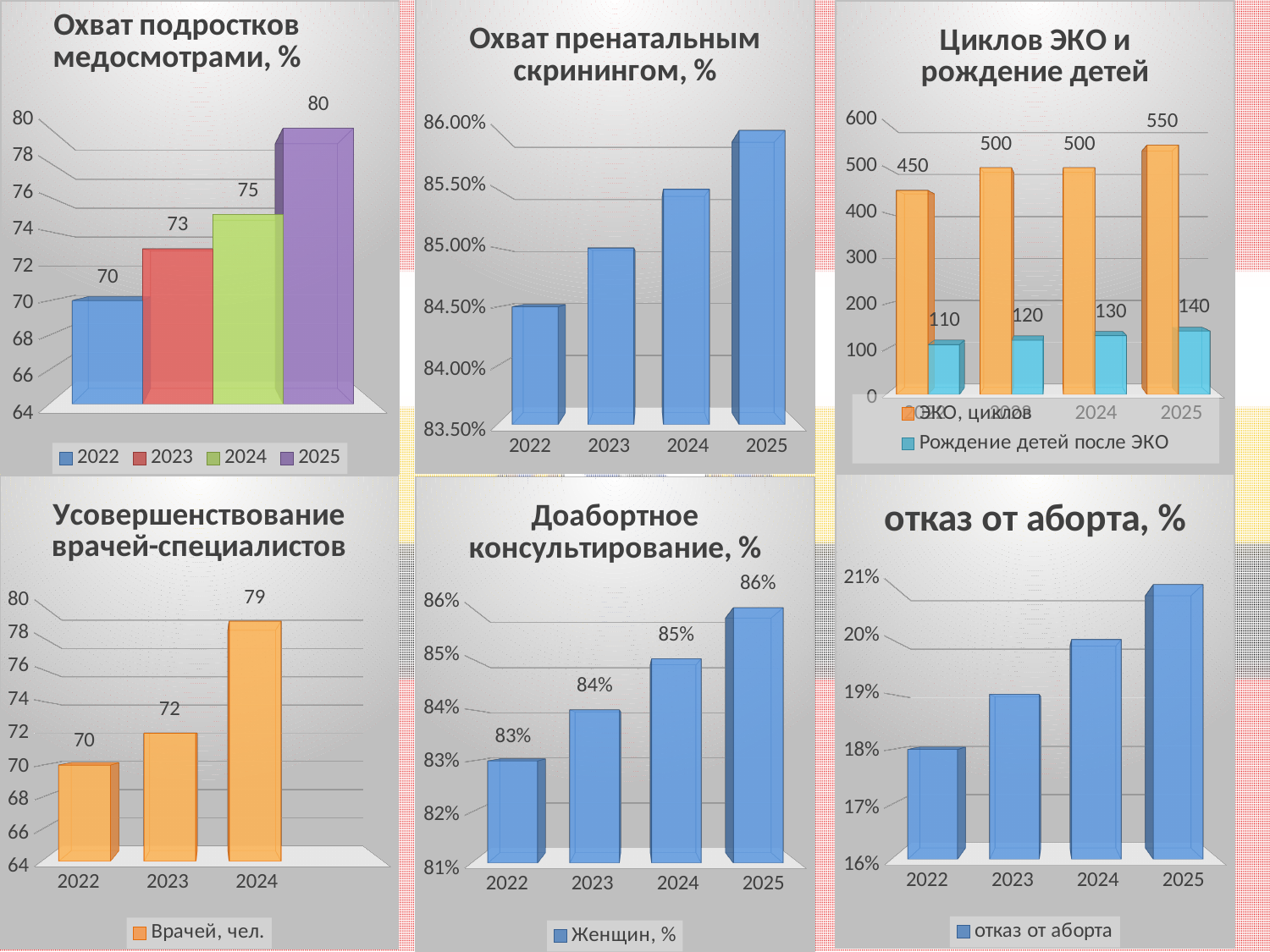
In the chart 'отказ от аборта, %', is the value for 2025 greater or less than 20%? greater In the chart 'Усовершенствование врачей-специалистов', how many years are shown on the x axis? 3 In the chart 'Охват подростков медосмотрами, %', what is the value for 2025? 80 In the chart 'Циклов ЭКО и рождение детей', what is the value of 'Рождение детей после ЭКО' for 2023? 120 In the chart 'Усовершенствование врачей-специалистов', what is the value for 2024? 79 In the chart 'Охват пренатальным скринингом, %', is the value for 2025 greater or less than 85.50%? greater In the chart 'Циклов ЭКО и рождение детей', which year has the lowest value for 'ЭКО, циклов'? 2022 In the chart 'Охват пренатальным скринингом, %', do the values rise or fall from 2022 to 2025? rise How many entries does the legend of the chart 'Охват подростков медосмотрами, %' list? 4 In the chart 'Охват подростков медосмотрами, %', what is the difference between the 2025 and 2022 values? 10 In the chart 'Циклов ЭКО и рождение детей', what is the value of 'ЭКО, циклов' for 2025? 550 In the chart 'Доабортное консультирование, %', which year has the highest value? 2025